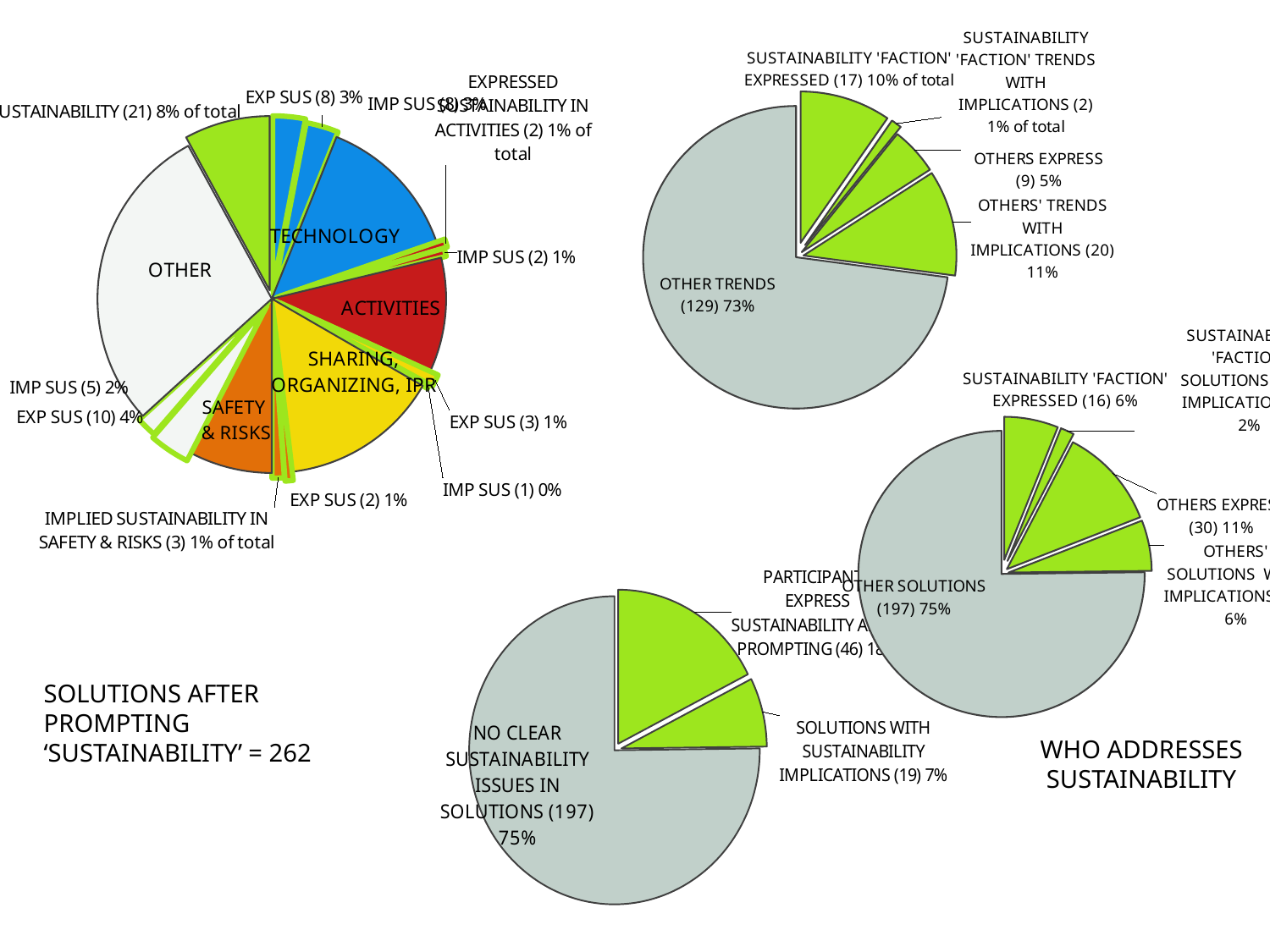
In the top-right pie chart (trends), what is the difference in count between OTHERS' TRENDS WITH IMPLICATIONS (20) and OTHERS EXPRESS (9)? 11 In the bottom-centre pie chart (solutions after prompting 'sustainability'), what percentage is labelled for NO CLEAR SUSTAINABILITY ISSUES IN SOLUTIONS? 75% In the middle-right pie chart (who addresses sustainability, solutions), how many solutions are counted under OTHERS EXPRESS? 30 In the bottom-centre pie chart (solutions after prompting 'sustainability'), how many solutions are counted as SOLUTIONS WITH SUSTAINABILITY IMPLICATIONS? 19 In the middle-right pie chart (who addresses sustainability, solutions), what percentage is labelled for OTHER SOLUTIONS? 75% What total number of solutions is stated in the text 'SOLUTIONS AFTER PROMPTING 'SUSTAINABILITY''? 262 What kind of chart is used for the bottom-centre chart on the slide? Pie chart In the bottom-centre pie chart, which slice is the largest? NO CLEAR SUSTAINABILITY ISSUES IN SOLUTIONS In the top-right pie chart (trends), what percentage is labelled for OTHER TRENDS? 73% In the top-right pie chart (trends), which slice is the smallest? SUSTAINABILITY 'FACTION' TRENDS WITH IMPLICATIONS In the top-right pie chart (trends), how many trends are counted under OTHERS' TRENDS WITH IMPLICATIONS? 20 In the top-left pie chart, what percentage is labelled for the EXP SUS slice with count (10)? 4%